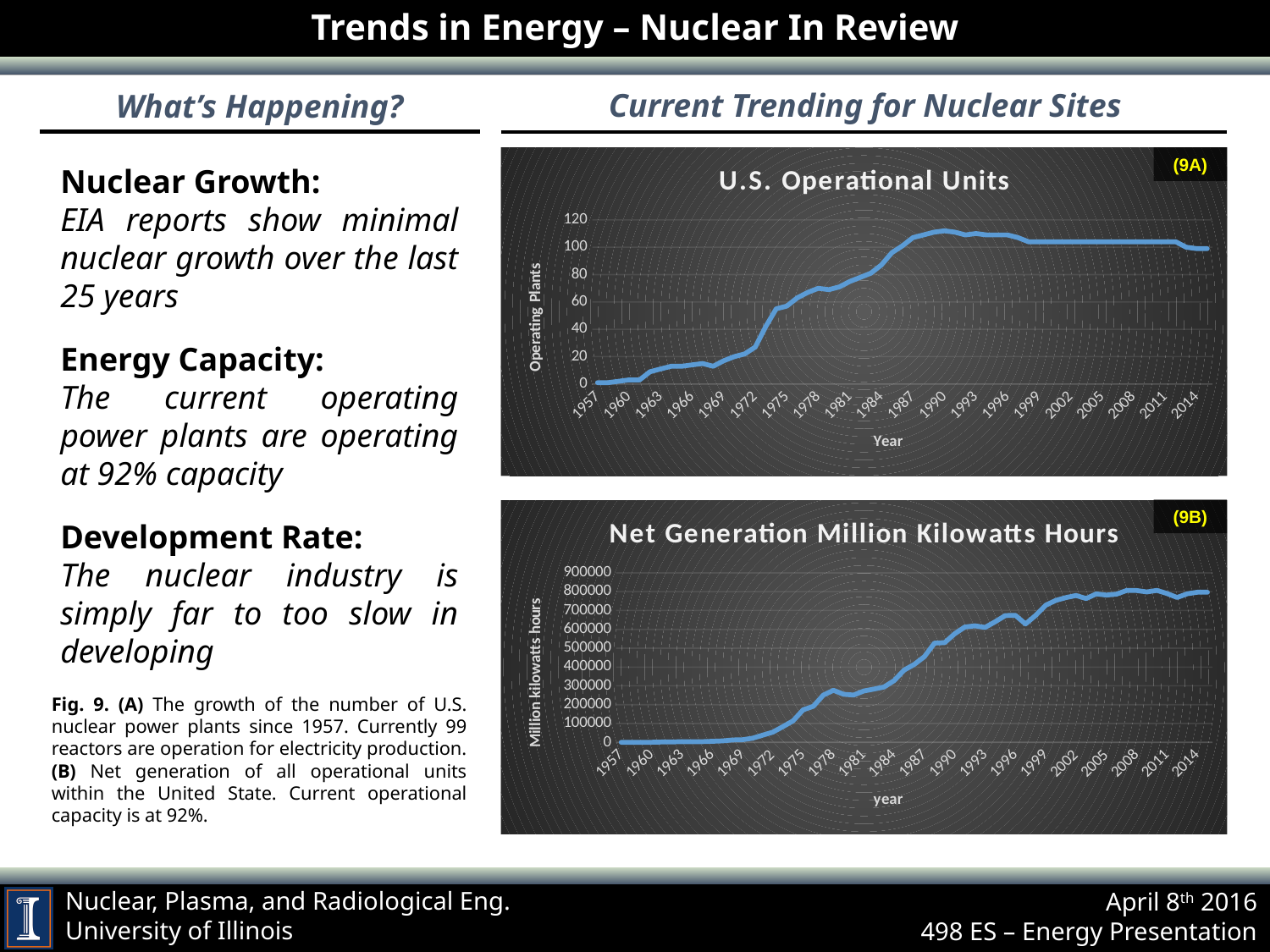
What is the y-axis label of the "U.S. Operational Units" chart? Operating Plants In the "Net Generation Million Kilowatts Hours" chart, is the value for 1990 greater or less than 500000? greater In the "Net Generation Million Kilowatts Hours" chart, is the value for 2014 greater or less than 900000? less In the "U.S. Operational Units" chart, is the value for 1957 greater or less than 20? less In the "U.S. Operational Units" chart, which year has the larger value, 1990 or 2014? 1990 What kind of chart is the "Net Generation Million Kilowatts Hours" chart? line chart What kind of chart is the "U.S. Operational Units" chart? line chart In the "U.S. Operational Units" chart, do the values generally rise or fall from 1957 to 1990? rise In the "Net Generation Million Kilowatts Hours" chart, which year has the larger value, 1975 or 2002? 2002 In the "Net Generation Million Kilowatts Hours" chart, do the values generally rise or fall along the x axis? rise